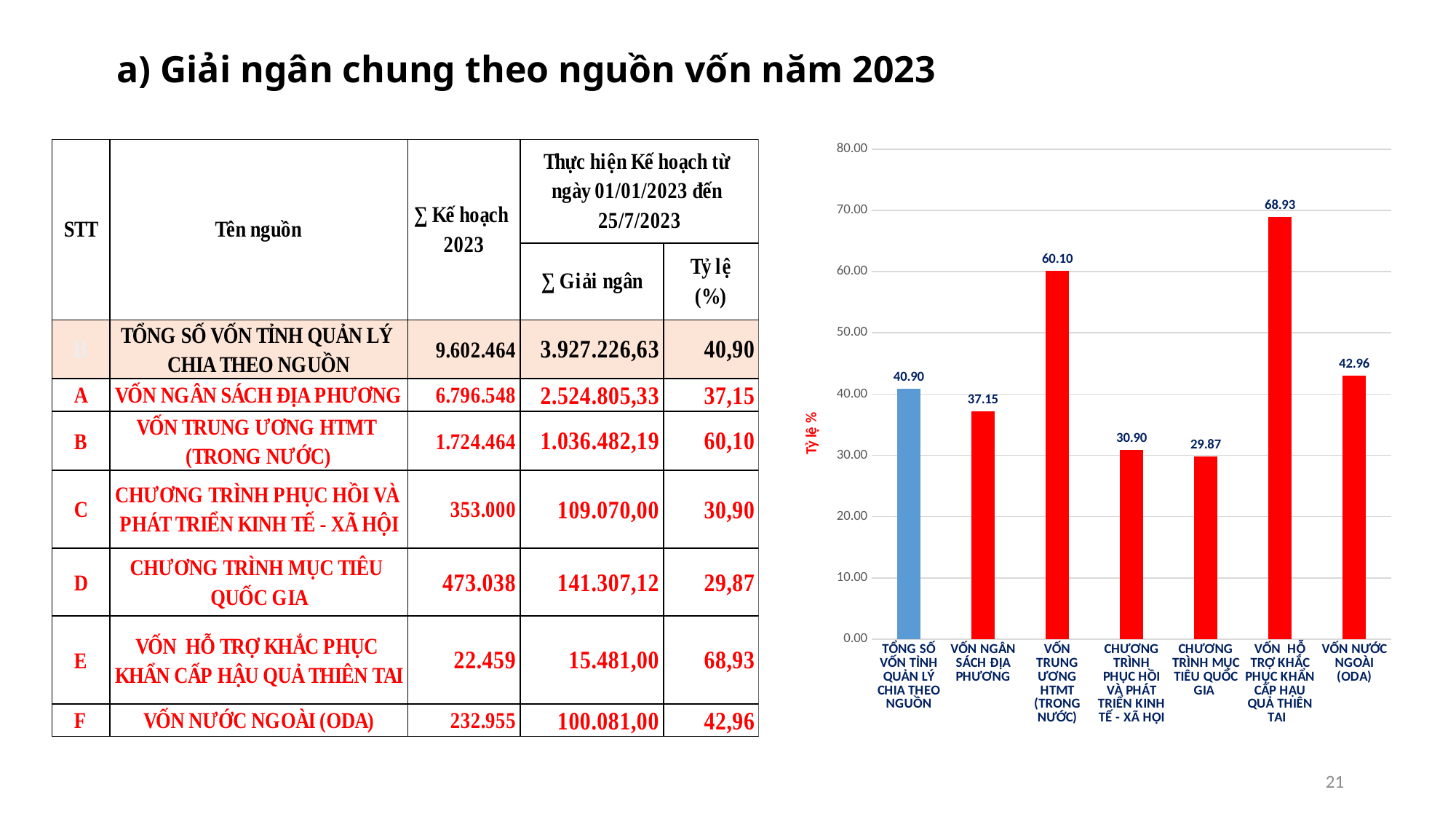
What is the value for VỐN NƯỚC NGOÀI (ODA) in the chart? 42.96 Which bar in the chart is coloured blue rather than red? TỔNG SỐ VỐN TỈNH QUẢN LÝ CHIA THEO NGUỒN Which category has the highest value in the chart? VỐN HỖ TRỢ KHẮC PHỤC KHẨN CẤP HẬU QUẢ THIÊN TAI What is the label on the vertical axis of the chart? Tỷ lệ % Which is larger in the chart: the value for VỐN NƯỚC NGOÀI (ODA) or the value for TỔNG SỐ VỐN TỈNH QUẢN LÝ CHIA THEO NGUỒN? VỐN NƯỚC NGOÀI (ODA) Which category has the lowest value in the chart? CHƯƠNG TRÌNH MỤC TIÊU QUỐC GIA Is the value for CHƯƠNG TRÌNH PHỤC HỒI VÀ PHÁT TRIỂN KINH TẾ - XÃ HỘI greater or less than 40.00? less What is the difference between the values for VỐN HỖ TRỢ KHẮC PHỤC KHẨN CẤP HẬU QUẢ THIÊN TAI and VỐN NGÂN SÁCH ĐỊA PHƯƠNG? 31.78 How many bars does the chart show? 7 What is the value for VỐN TRUNG ƯƠNG HTMT (TRONG NƯỚC) in the chart? 60.10 What is the value for CHƯƠNG TRÌNH MỤC TIÊU QUỐC GIA in the chart? 29.87 What type of chart is shown on the slide? bar chart